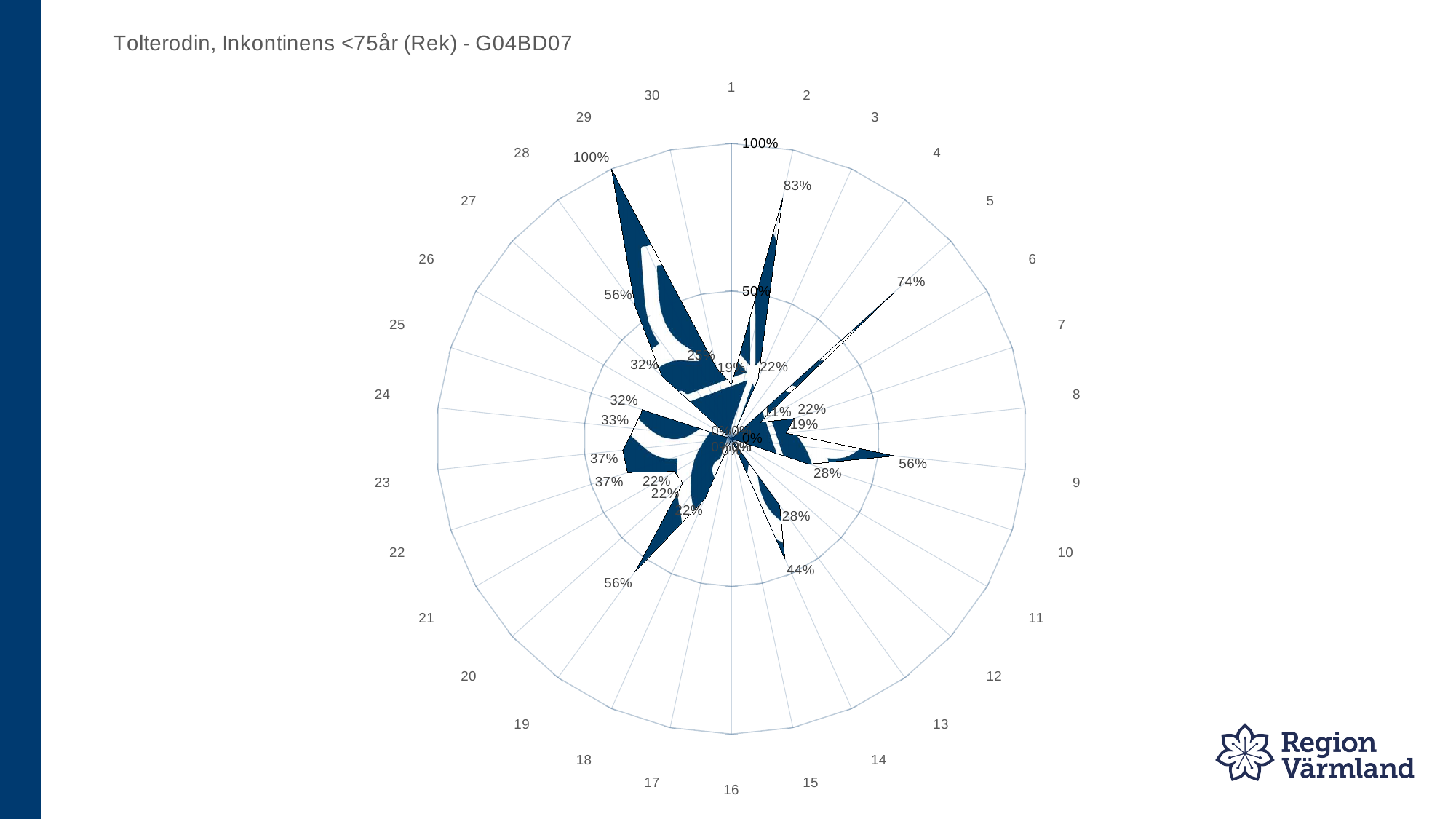
Is the value for category 11 greater or less than 50%? less What is the value for category 17? 0% What is the title of the chart? Tolterodin, Inkontinens <75år (Rek) - G04BD07 What is the value for category 2? 83% Is the value for category 29 greater or less than 50%? greater What is the value for category 6? 11% What is the difference between the value for category 29 and the value for category 17? 100 percentage points What is the value for category 29? 100% How many categories are plotted around the radar chart? 30 What kind of chart is shown on the slide? Radar chart What is the difference between the value for category 2 and the value for category 6? 72 percentage points Which is larger, the value for category 6 or the value for category 8? Category 8